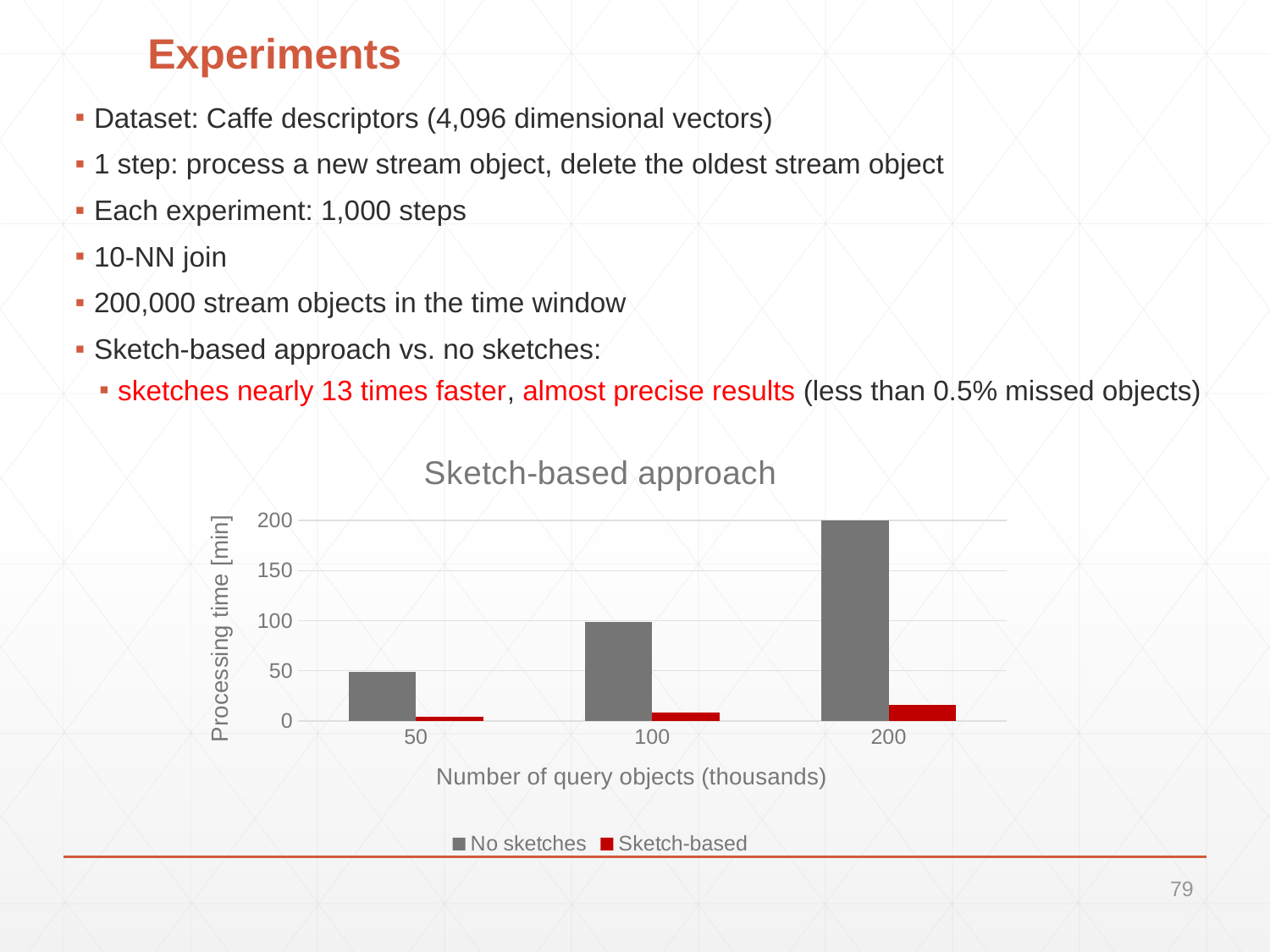
For which number of query objects is the Sketch-based processing time lowest? 50 What kind of chart is shown on the slide? bar chart Is the No sketches value at 200 thousand query objects greater or less than 150? greater What is the label of the y axis of the chart? Processing time [min] How many categories are shown on the x axis of the chart? 3 Is the No sketches value at 50 thousand query objects greater or less than 100? less How many series does the chart's legend list? 2 What is the title of the chart? Sketch-based approach Do the No sketches values rise or fall as the number of query objects increases? rise For which number of query objects is the No sketches processing time highest? 200 At 100 thousand query objects, which series has the larger processing time, No sketches or Sketch-based? No sketches Is the Sketch-based value at 200 thousand query objects greater or less than 50? less